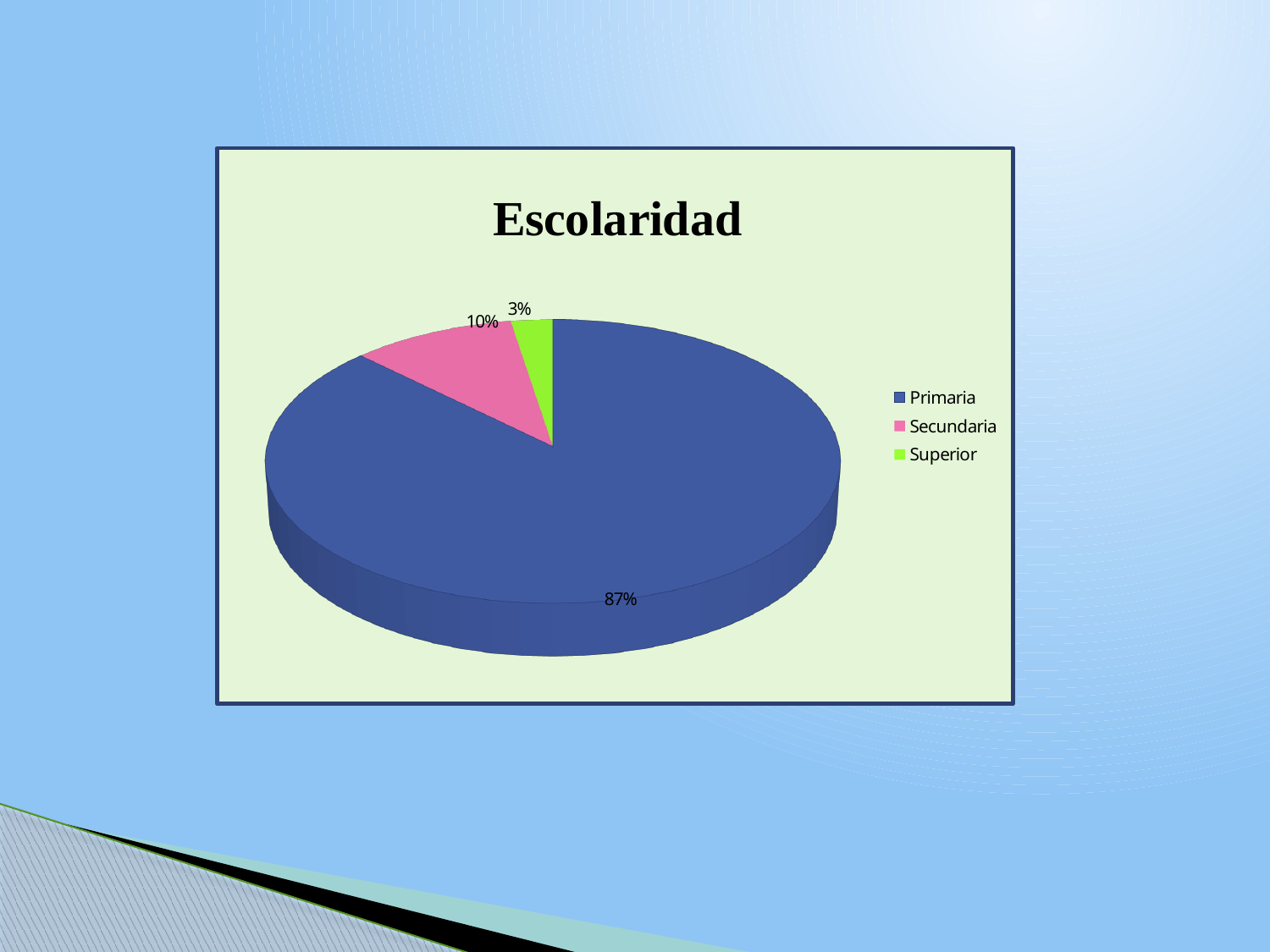
What kind of chart is shown on the slide? pie chart Which category has the smallest share of the pie? Superior What percentage does the Secundaria slice show? 10% Which category has the largest share of the pie? Primaria Which is larger, the Secundaria slice or the Superior slice? Secundaria What is the difference in percentage points between Secundaria and Superior? 7 What colour is the Secundaria slice? pink What is the title of the chart? Escolaridad What percentage does the Primaria slice show? 87% How many categories does the pie chart have? 3 What is the difference in percentage points between Primaria and Secundaria? 77 What percentage does the Superior slice show? 3%